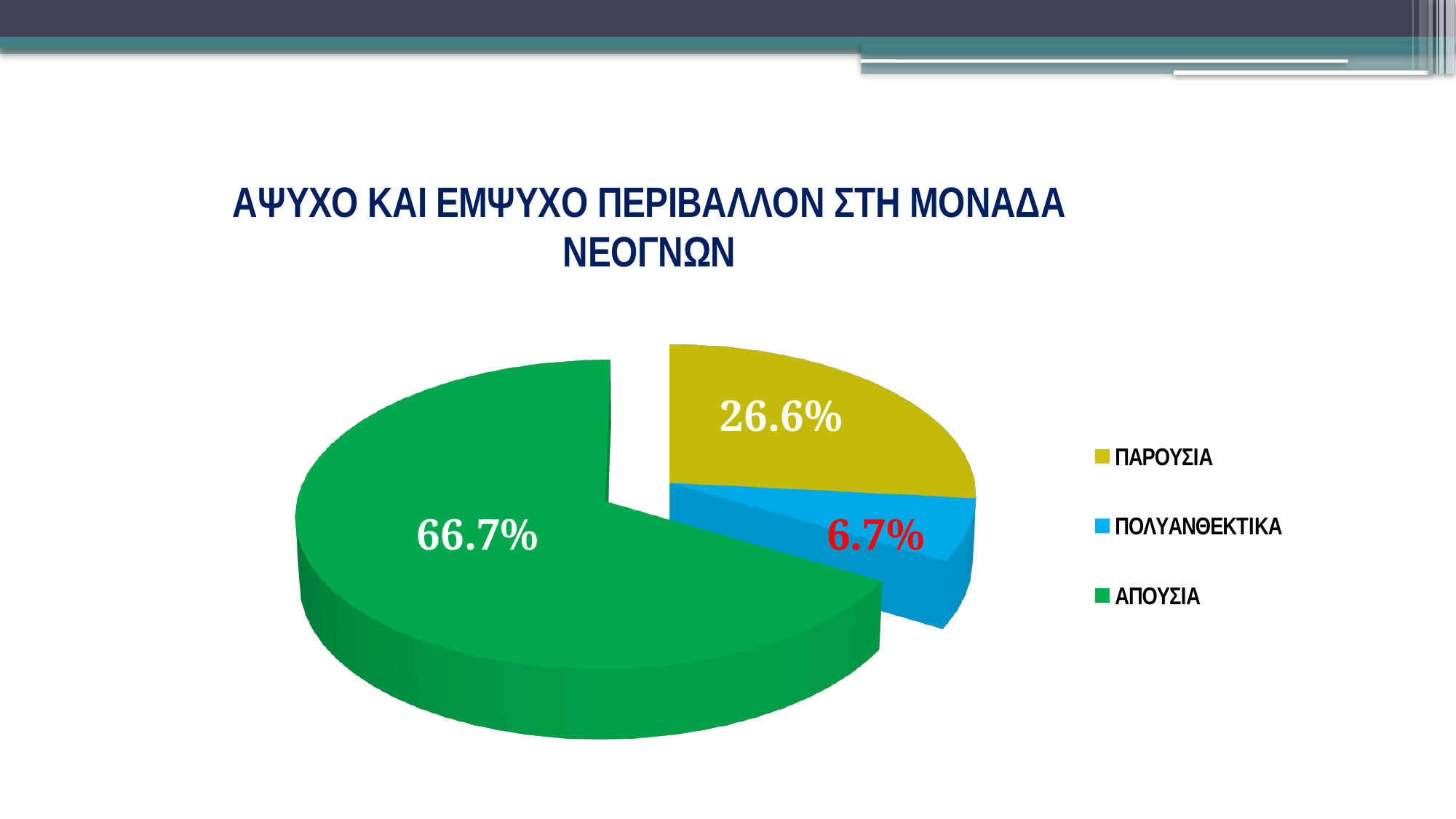
What is the title of the chart? ΑΨΥΧΟ ΚΑΙ ΕΜΨΥΧΟ ΠΕΡΙΒΑΛΛΟΝ ΣΤΗ ΜΟΝΑΔΑ ΝΕΟΓΝΩΝ What type of chart is shown on the slide? Pie chart Which is larger, the value for ΠΑΡΟΥΣΙΑ or the value for ΠΟΛΥΑΝΘΕΚΤΙΚΑ? ΠΑΡΟΥΣΙΑ What is the value for ΠΑΡΟΥΣΙΑ? 26.6% What colour is the slice for ΠΟΛΥΑΝΘΕΚΤΙΚΑ? Blue What is the difference between the values for ΑΠΟΥΣΙΑ and ΠΑΡΟΥΣΙΑ? 40.1% Which category has the smallest share of the pie? ΠΟΛΥΑΝΘΕΚΤΙΚΑ Which category has the largest share of the pie? ΑΠΟΥΣΙΑ What is the difference between the values for ΠΑΡΟΥΣΙΑ and ΠΟΛΥΑΝΘΕΚΤΙΚΑ? 19.9% How many slices does the pie chart have? 3 What is the value for ΑΠΟΥΣΙΑ? 66.7% What is the value for ΠΟΛΥΑΝΘΕΚΤΙΚΑ? 6.7%